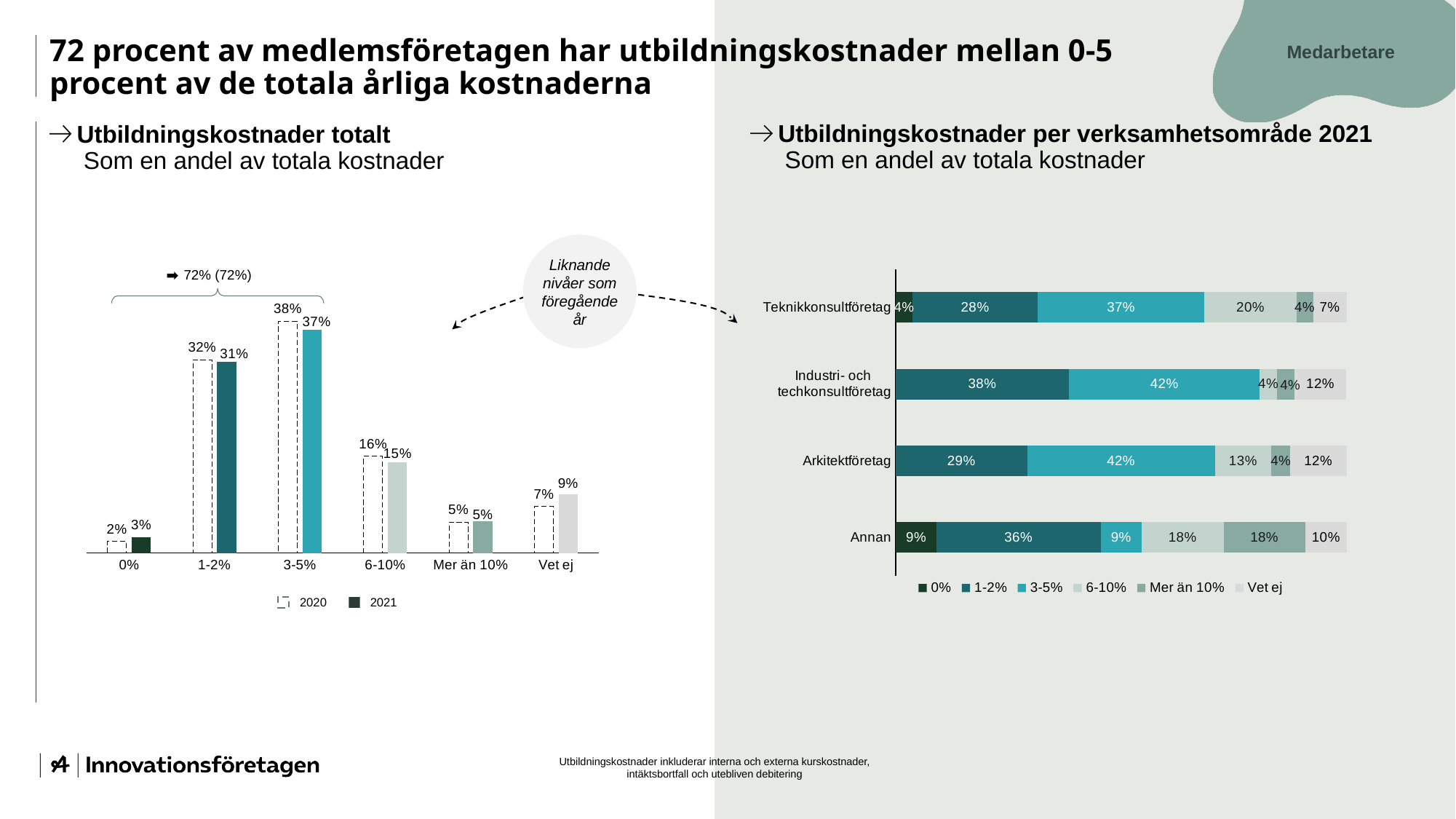
In the chart 'Utbildningskostnader totalt', what is the 2020 value for the 1-2% category? 32% In the chart 'Utbildningskostnader per verksamhetsområde 2021', what is the 1-2% share for Annan? 36% In the chart 'Utbildningskostnader totalt', how many categories are shown on the x axis? 6 In the chart 'Utbildningskostnader totalt', which category has the lowest 2020 value? 0% In the chart 'Utbildningskostnader per verksamhetsområde 2021', what is the 3-5% share for Arkitektföretag? 42% What kind of chart is 'Utbildningskostnader per verksamhetsområde 2021'? Stacked bar chart In the chart 'Utbildningskostnader totalt', what is the 2021 value for the 3-5% category? 37% In the chart 'Utbildningskostnader per verksamhetsområde 2021', which is larger: the 6-10% share for Teknikkonsultföretag or for Arkitektföretag? Teknikkonsultföretag In the chart 'Utbildningskostnader totalt', what is the difference between the 2020 and 2021 values for the Vet ej category? 2% In the chart 'Utbildningskostnader totalt', which category has the highest 2021 value? 3-5% In the chart 'Utbildningskostnader totalt', how many series does the legend list? 2 In the chart 'Utbildningskostnader per verksamhetsområde 2021', how many series does the legend list? 6